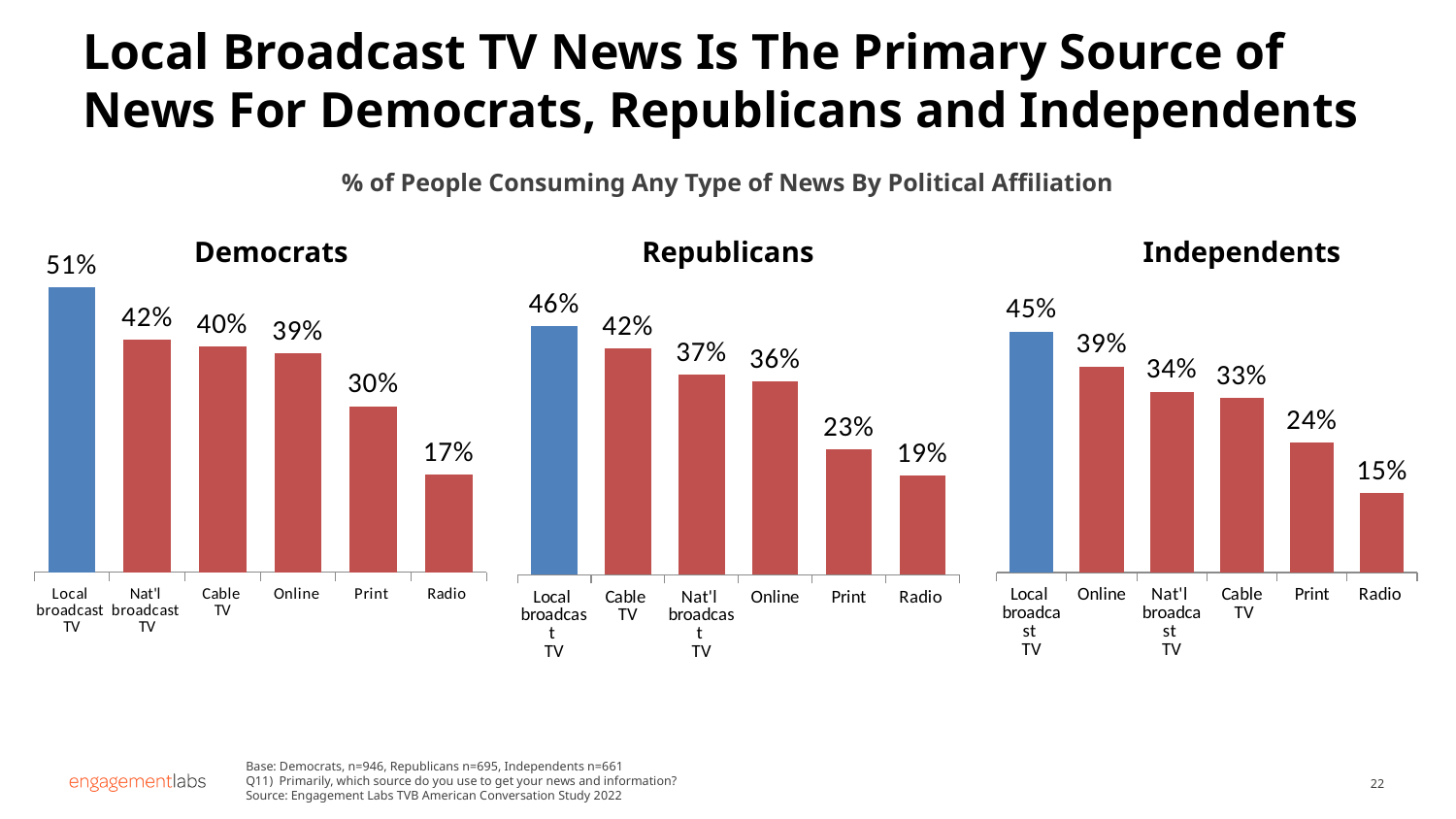
In the Independents chart, what is the value for Print? 24% In the Democrats chart, what is the value for Local broadcast TV? 51% How many categories are shown in the Democrats chart? 6 In the Republicans chart, which category has the highest value? Local broadcast TV In the Independents chart, which category has the lowest value? Radio In the Democrats chart, what is the difference between Local broadcast TV and Radio? 34% What kind of chart is the Republicans chart? Bar chart In the Democrats chart, do the values rise or fall from left to right? Fall In the Republicans chart, what is the difference between Online and Print? 13% What is the subtitle shown above the three charts? % of People Consuming Any Type of News By Political Affiliation In the Republicans chart, what is the value for Cable TV? 42% In the Independents chart, which is larger, Online or Cable TV? Online